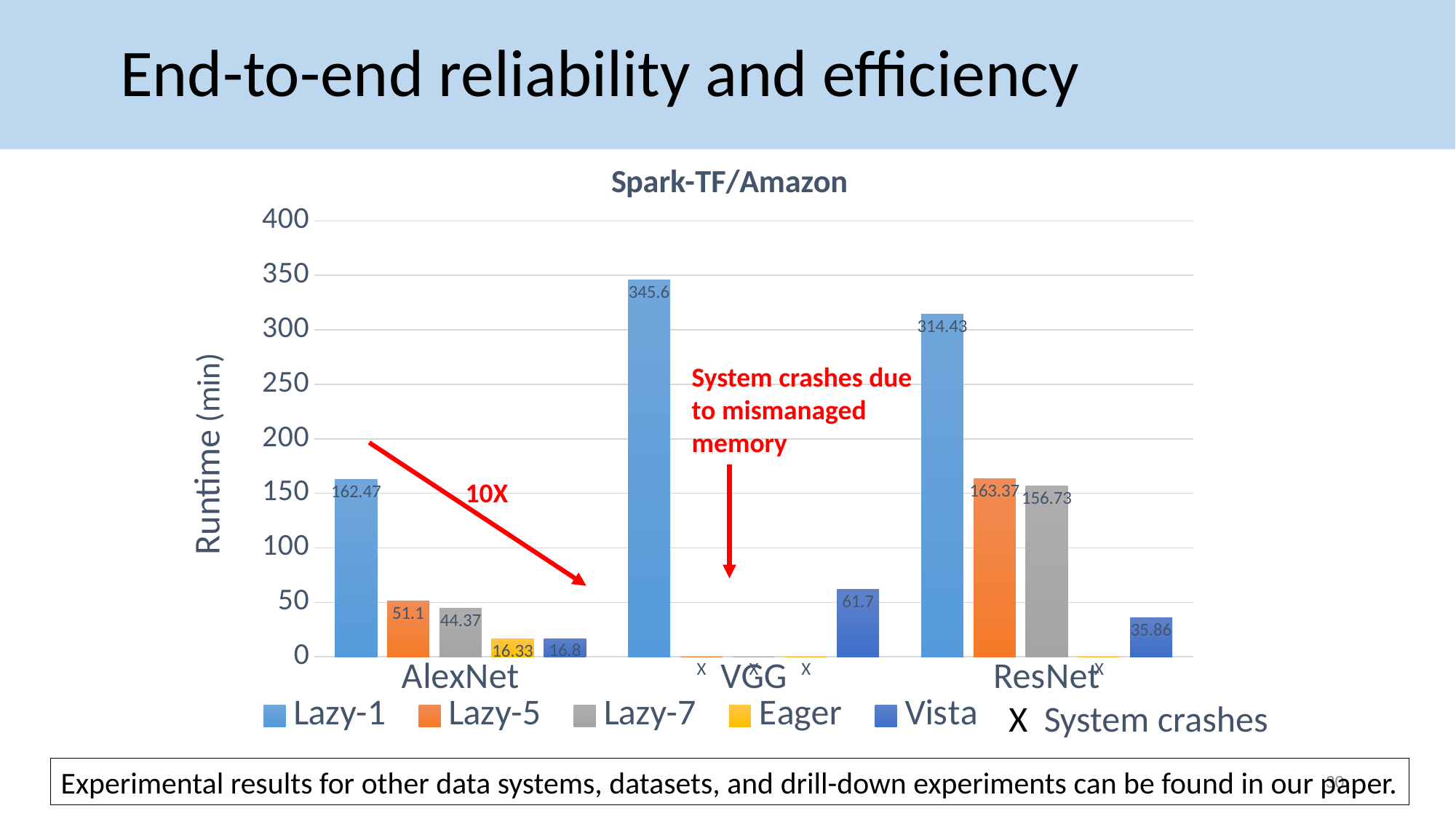
What is the title of the chart? Spark-TF/Amazon What type of chart is shown on the slide? bar chart What is the runtime for Lazy-1 on AlexNet? 162.47 What is the runtime for Vista on VGG? 61.7 Which is larger on AlexNet, the Lazy-5 runtime or the Lazy-7 runtime? Lazy-5 Which series has the lowest runtime on AlexNet? Eager What is the difference between the Lazy-1 and Vista runtimes on ResNet? 278.57 How many categories are shown on the x axis? 3 Is the Lazy-1 runtime on VGG greater or less than 300? greater Which category has the highest Lazy-1 runtime? VGG What is the runtime for Lazy-7 on ResNet? 156.73 How many series does the chart legend list? 5